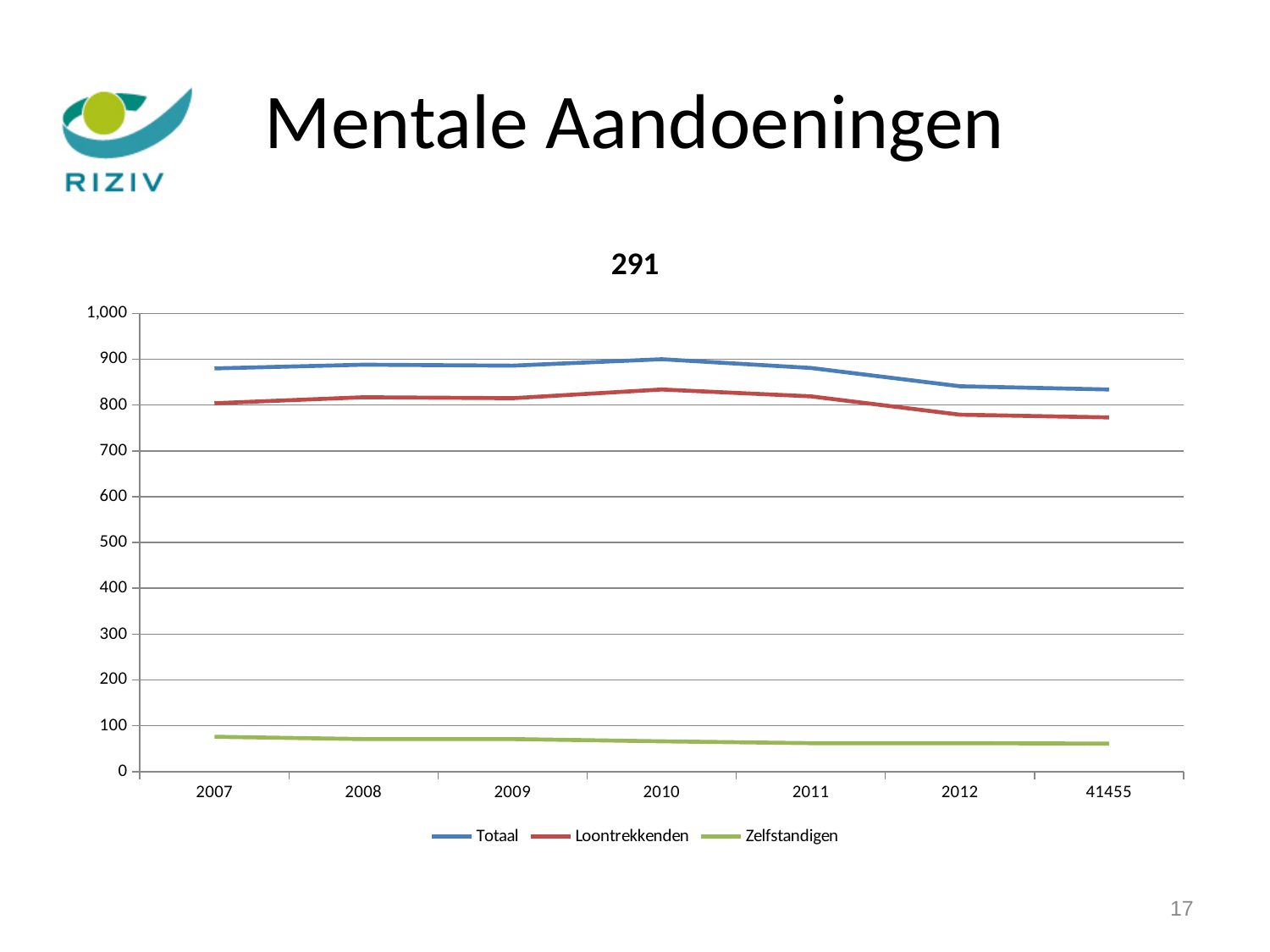
What kind of chart is shown on the slide? line chart What is the title of the chart? 291 Is the value for Zelfstandigen in 2007 greater or less than 100? less Which colour is used for the Zelfstandigen line? green Is the value for Totaal in 2010 greater or less than 800? greater Does the Totaal line rise or fall between 2010 and 2012? fall Is the value for Loontrekkenden in 2012 greater or less than 800? less In which year does the Totaal line reach its highest value? 2010 In 2011, which is larger: Totaal or Zelfstandigen? Totaal How many points are plotted along the x axis for each series? 7 How many series does the legend list? 3